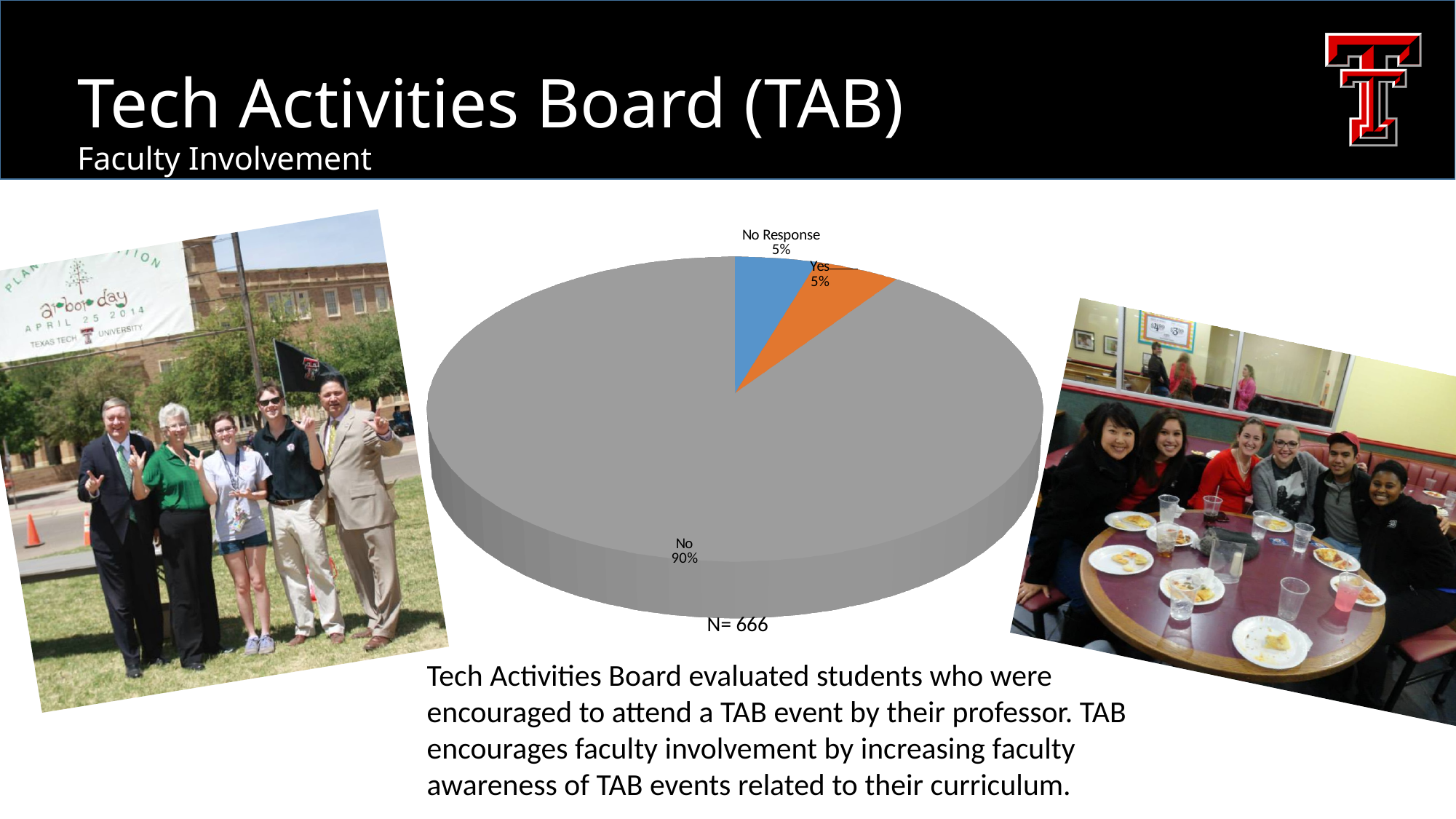
Is the "No" slice larger or smaller than the "Yes" slice? Larger What percentage of the pie chart is labelled "Yes"? 5% How many slices does the pie chart have? 3 What percentage of the pie chart is labelled "No Response"? 5% What is the sample size (N) shown below the pie chart? N= 666 What colour is the "No" slice of the pie chart? Gray What is the difference in percentage points between the "No" slice and the "Yes" slice? 85 Which category has the largest slice of the pie chart? No What percentage of the pie chart is labelled "No"? 90% What kind of chart is shown on the slide? Pie chart